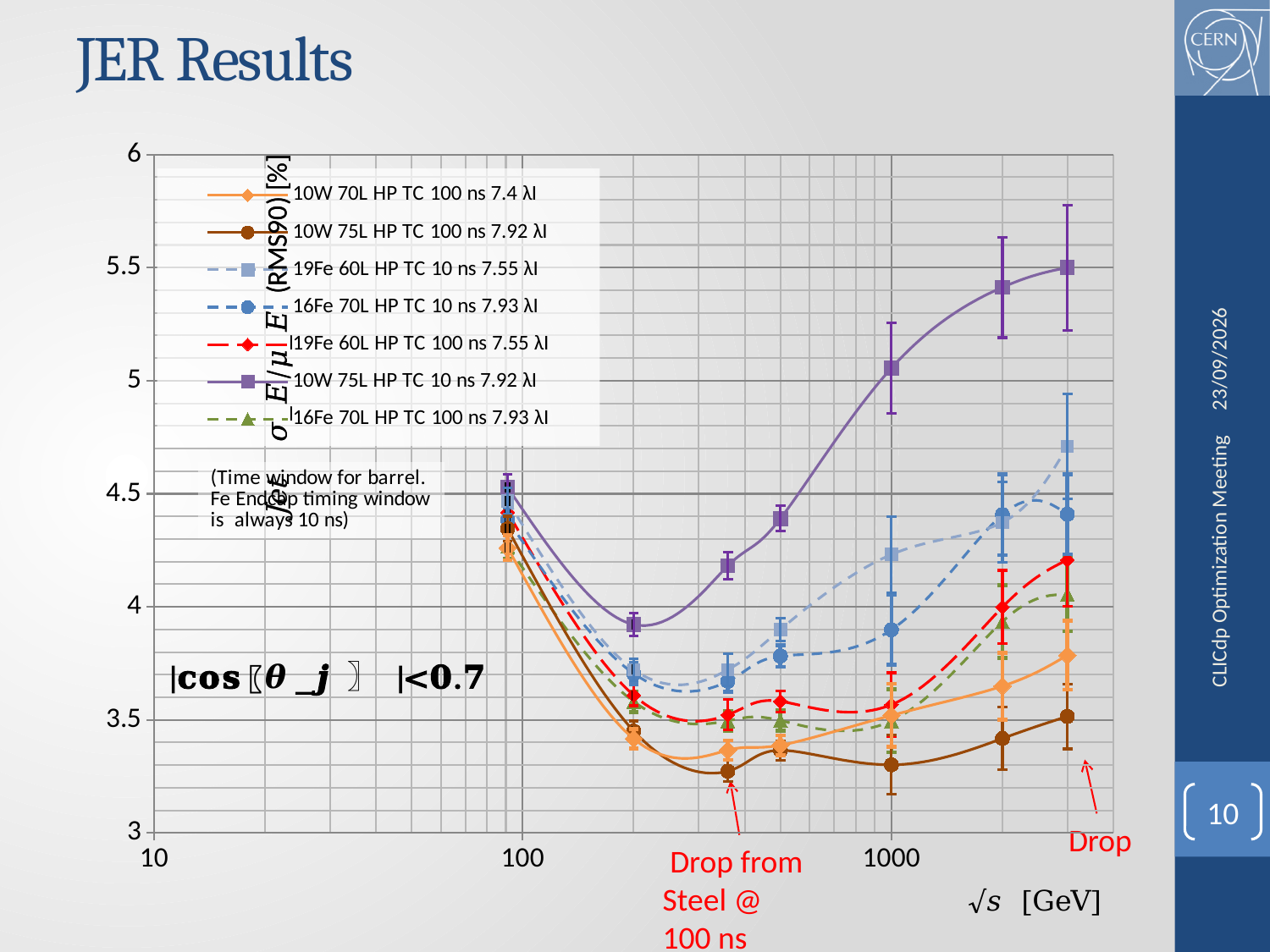
Which series has the highest value at 3000 GeV? 10W 75L HP TC 10 ns 7.92 λI How many data points does each series have? 7 How many series does the legend list? 7 What kind of chart is shown on the slide? line chart Is the value of the 10W 75L HP TC 10 ns 7.92 λI series at 3000 GeV greater or less than 5? greater Which series has the lowest value at 3000 GeV? 10W 75L HP TC 100 ns 7.92 λI What is the label of the x axis? √s [GeV] Is the value of the 19Fe 60L HP TC 10 ns 7.55 λI series at 3000 GeV greater or less than 4.5? greater At 1000 GeV, which is larger: the 16Fe 70L HP TC 10 ns 7.93 λI series or the 10W 75L HP TC 100 ns 7.92 λI series? 16Fe 70L HP TC 10 ns 7.93 λI What is the title of the slide containing the chart? JER Results Does the 10W 75L HP TC 10 ns 7.92 λI series rise or fall between 200 GeV and 3000 GeV? rise Is the value of the 10W 75L HP TC 100 ns 7.92 λI series at 1000 GeV greater or less than 3.5? less